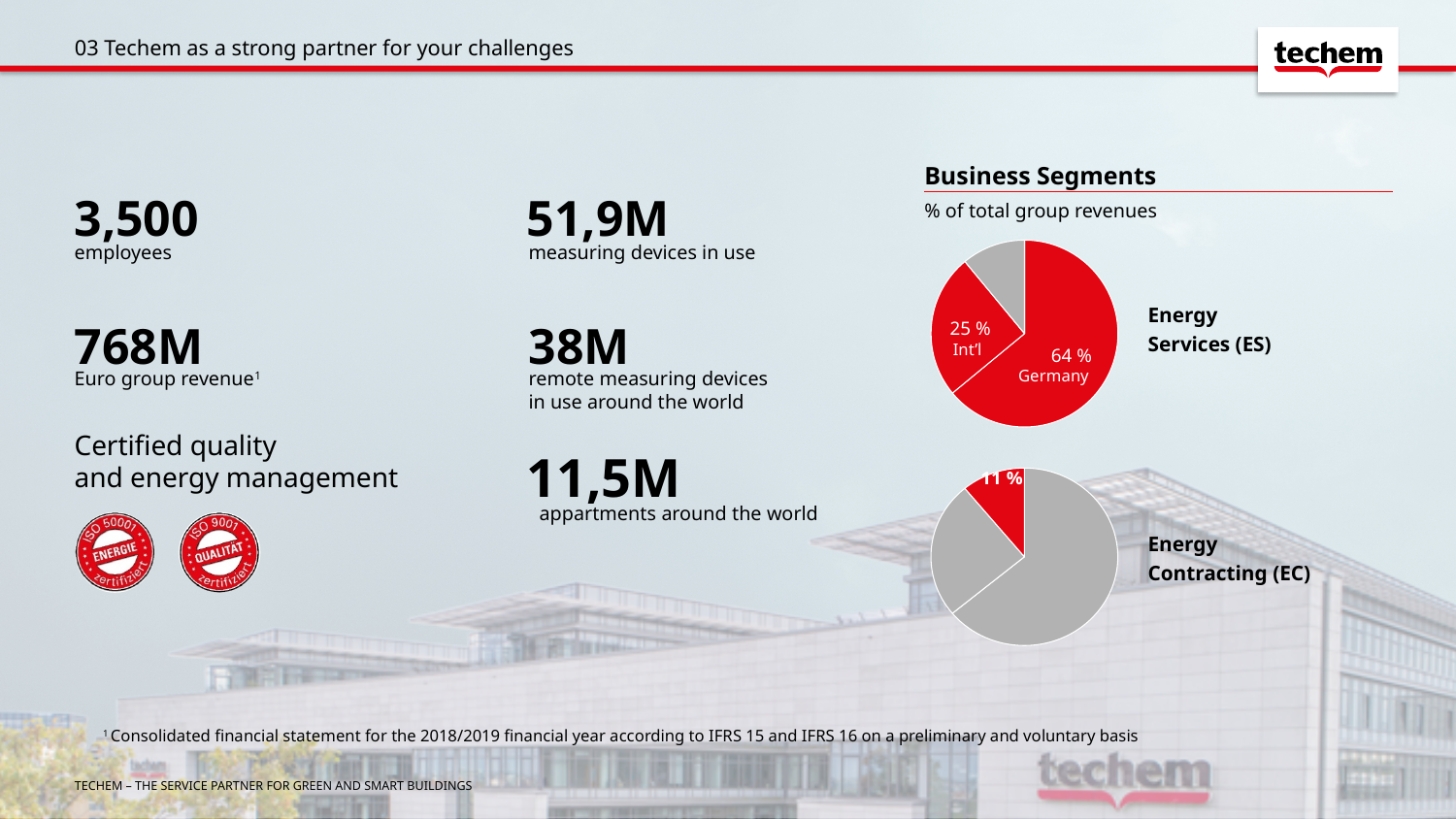
What do the pie charts measure, according to the subtitle under Business Segments? % of total group revenues Which business segment's pie chart shows a slice labelled 11 %? Energy Contracting (EC) In the Energy Services (ES) pie chart, which is larger: the Germany slice or the Int'l slice? Germany How many slices does the Energy Services (ES) pie chart have? 3 In the Energy Services (ES) pie chart, what share of revenues is labelled Int'l? 25 % How many pie charts are shown under Business Segments? 2 In the Energy Services (ES) pie chart, what is the difference between the Germany share and the Int'l share? 39 % In the Energy Contracting (EC) pie chart, what percentage is shown on the red slice? 11 % In the Energy Services (ES) pie chart, what share of revenues comes from Germany? 64 % What is the title above the pie charts? Business Segments In the Energy Services (ES) pie chart, which labelled slice is the largest? Germany What type of chart is used to show the Business Segments? Pie chart